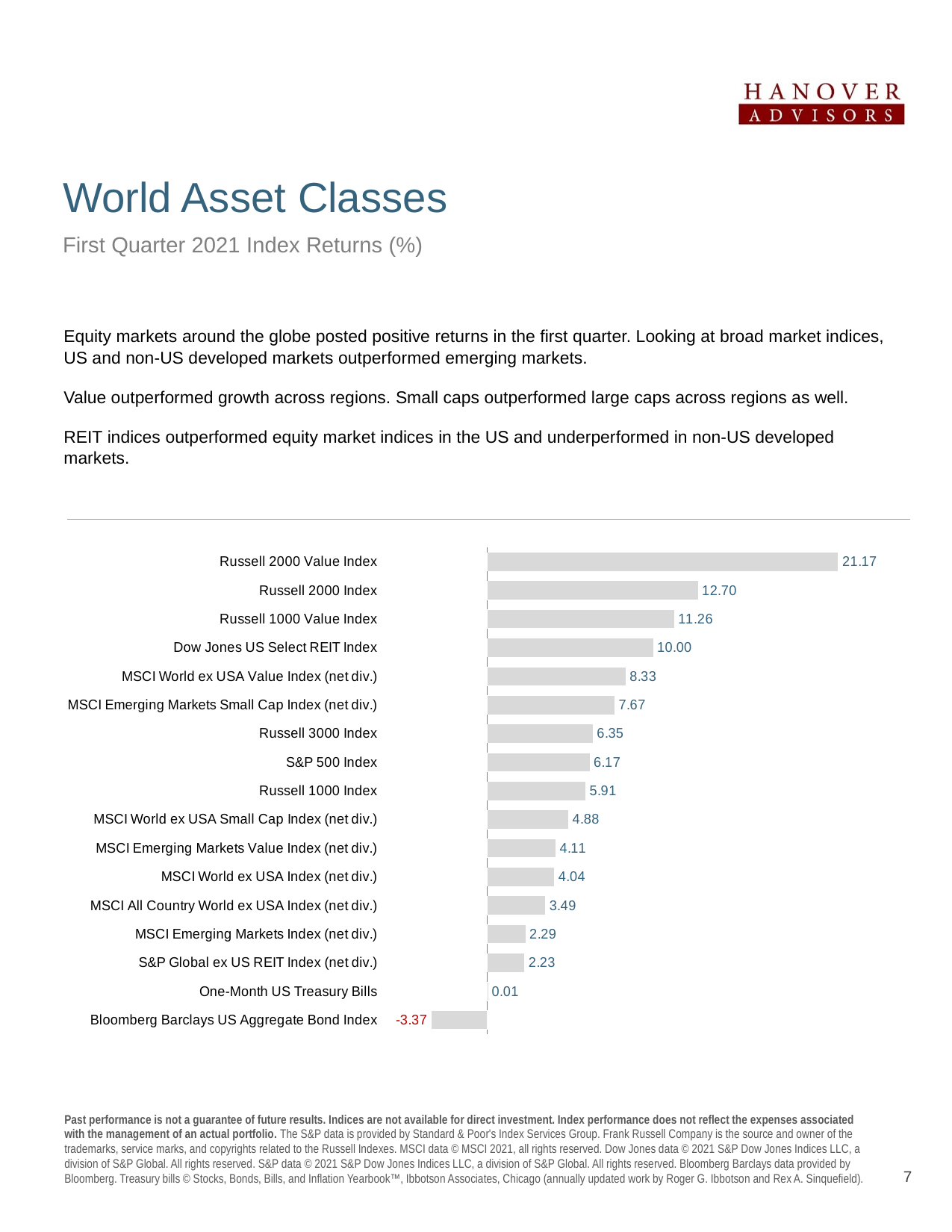
What is the value for the Dow Jones US Select REIT Index? 10.00 What is the difference between the Russell 2000 Index and the Russell 1000 Index values? 6.79 What kind of chart is shown on the slide? Bar chart Which index has the highest value on the chart? Russell 2000 Value Index How many indices are plotted on the chart? 17 What is the difference between the Russell 1000 Value Index and the Russell 1000 Index values? 5.35 What is the value for the Bloomberg Barclays US Aggregate Bond Index? -3.37 Which is larger, the value for the MSCI Emerging Markets Small Cap Index (net div.) or the MSCI Emerging Markets Index (net div.)? MSCI Emerging Markets Small Cap Index (net div.) What is the value for the Russell 2000 Value Index? 21.17 What is the subtitle of the chart on the slide? First Quarter 2021 Index Returns (%) What is the value for the S&P 500 Index? 6.17 Which index has the lowest value on the chart? Bloomberg Barclays US Aggregate Bond Index